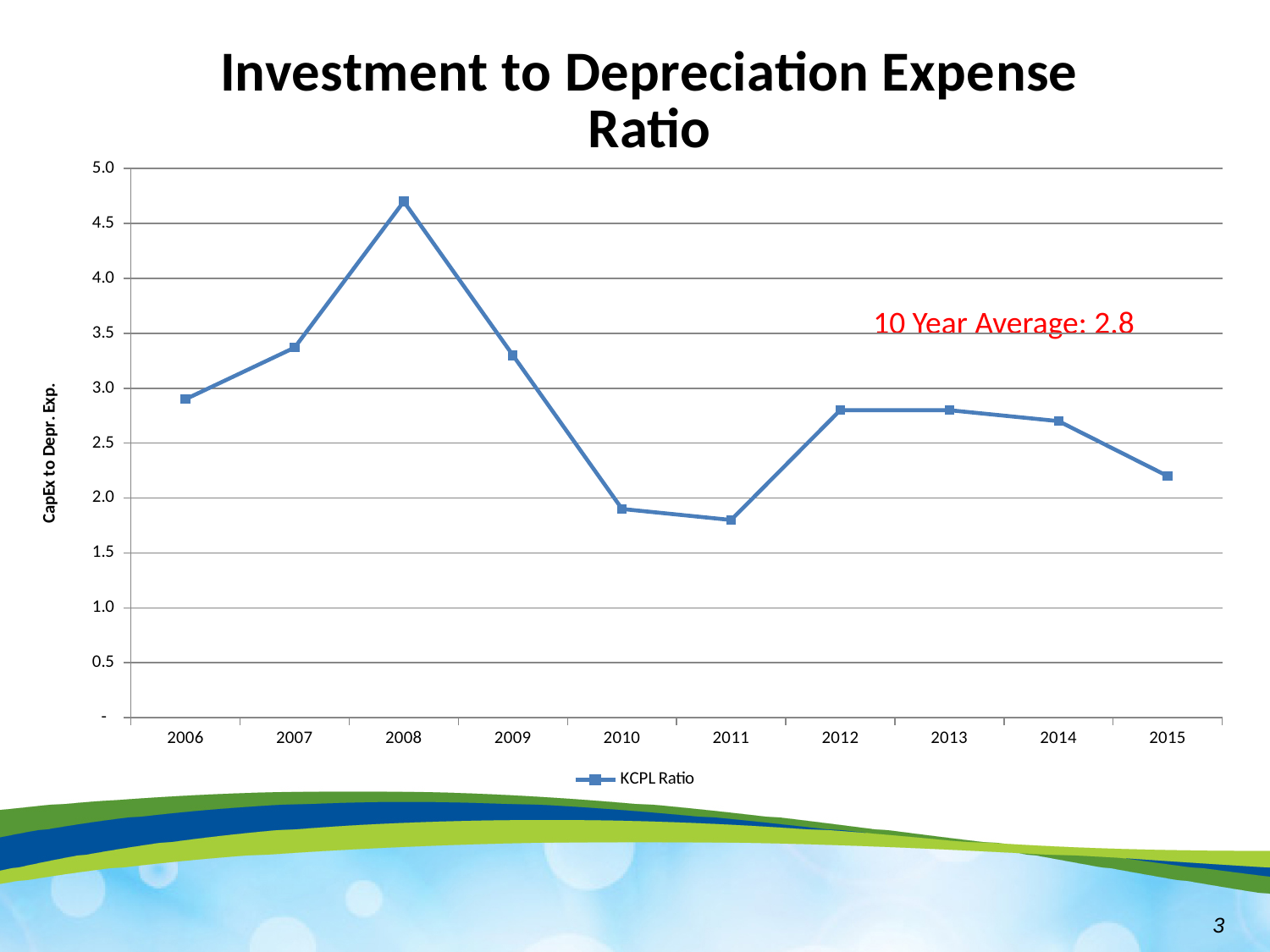
Is the KCPL Ratio for 2008 greater or less than 4.5? greater Which year has the highest KCPL Ratio? 2008 What kind of chart is shown on the slide? line chart Is the KCPL Ratio for 2015 greater or less than 2.5? less How many series does the legend list? 1 Does the KCPL Ratio rise or fall from 2008 to 2011? fall How many years are plotted along the x axis? 10 What series name does the legend show? KCPL Ratio Is the KCPL Ratio for 2011 greater or less than 2.0? less Which year has the larger KCPL Ratio, 2007 or 2014? 2007 Does the KCPL Ratio rise or fall from 2006 to 2008? rise What is the title of the chart? Investment to Depreciation Expense Ratio